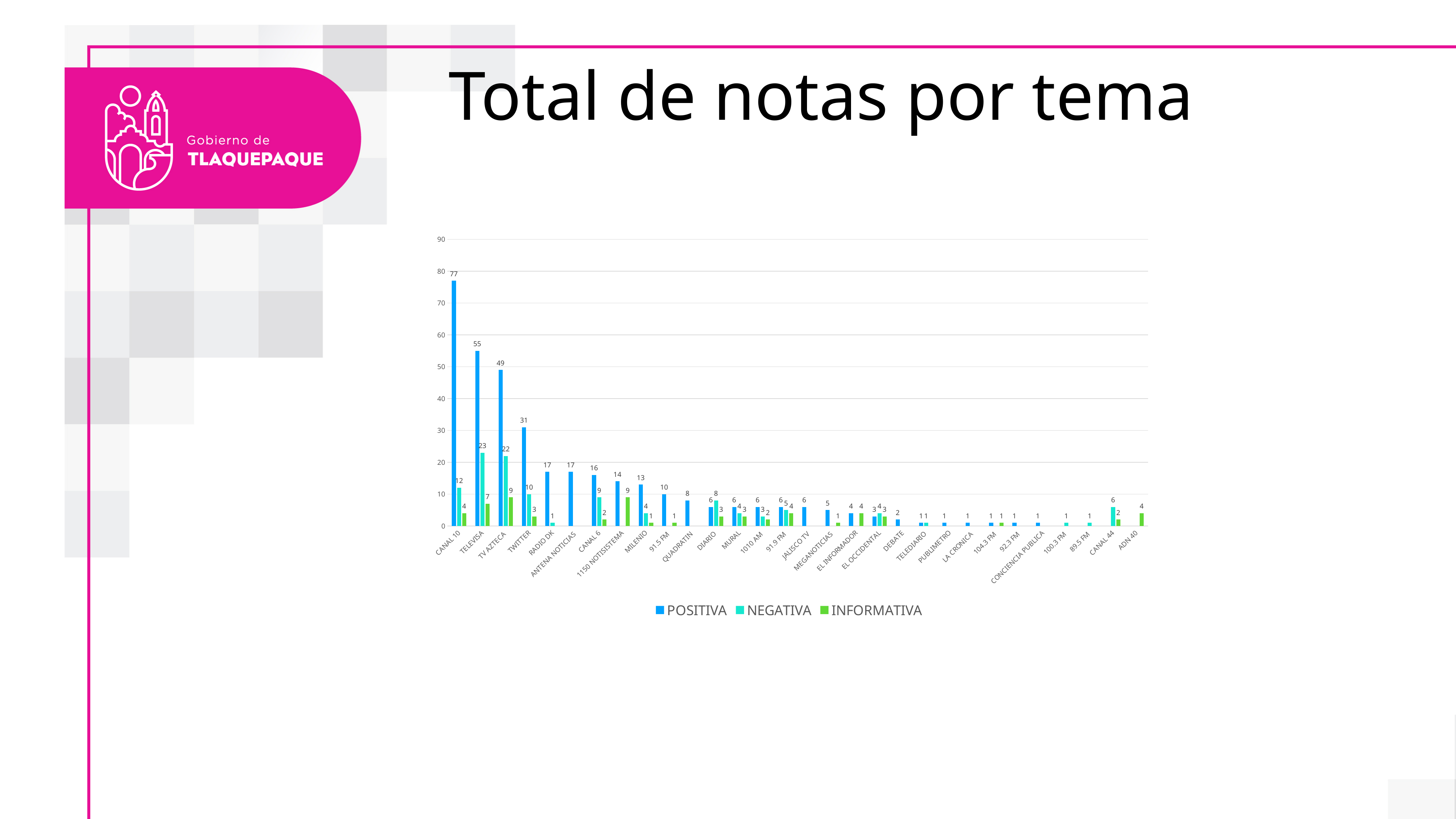
What is the POSITIVA value for MILENIO? 13 What is the title of the slide? Total de notas por tema What kind of chart is shown on the slide? bar chart Which category has the highest POSITIVA value? CANAL 10 What is the POSITIVA value for CANAL 10? 77 What is the difference between the POSITIVA values for TELEVISA and TV AZTECA? 6 What is the INFORMATIVA value for TV AZTECA? 9 Is the POSITIVA value for CANAL 10 greater or less than 70? greater What is the NEGATIVA value for DIARIO? 8 How many series does the legend list? 3 What is the NEGATIVA value for TELEVISA? 23 Which is larger, the POSITIVA value for TWITTER or the POSITIVA value for RADIO DK? TWITTER